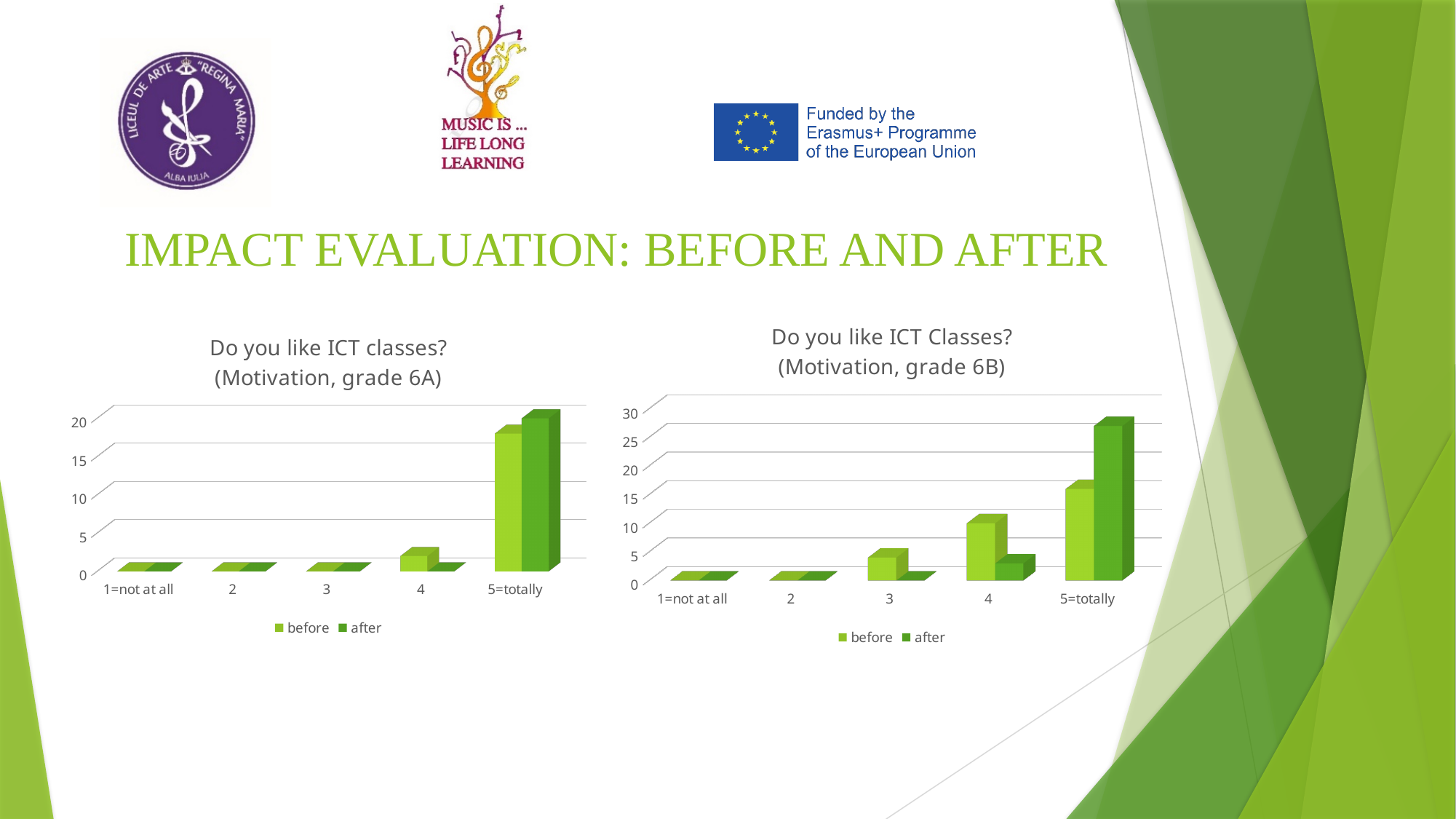
In the right chart (grade 6B), how many series does the legend list? 2 What are the two legend entries in the left chart (grade 6A)? before, after What kind of chart is the left chart titled "Do you like ICT classes? (Motivation, grade 6A)"? bar chart In the left chart (grade 6A), how many categories are shown on the x axis? 5 In the right chart (grade 6B), which category has the highest "before" value? 5=totally In the left chart (grade 6A), is the "before" value for 5=totally greater or less than 10? greater In the right chart (grade 6B), is the "after" value for 5=totally greater or less than 20? greater In the right chart (grade 6B), for category 4, which is larger: the "before" value or the "after" value? before In the right chart (grade 6B), is the "before" value for category 4 greater or less than 5? greater What is the title of the right chart? Do you like ICT Classes? (Motivation, grade 6B) In the right chart (grade 6B), for category 5=totally, which is larger: the "before" value or the "after" value? after In the left chart (grade 6A), which category has the highest "after" value? 5=totally